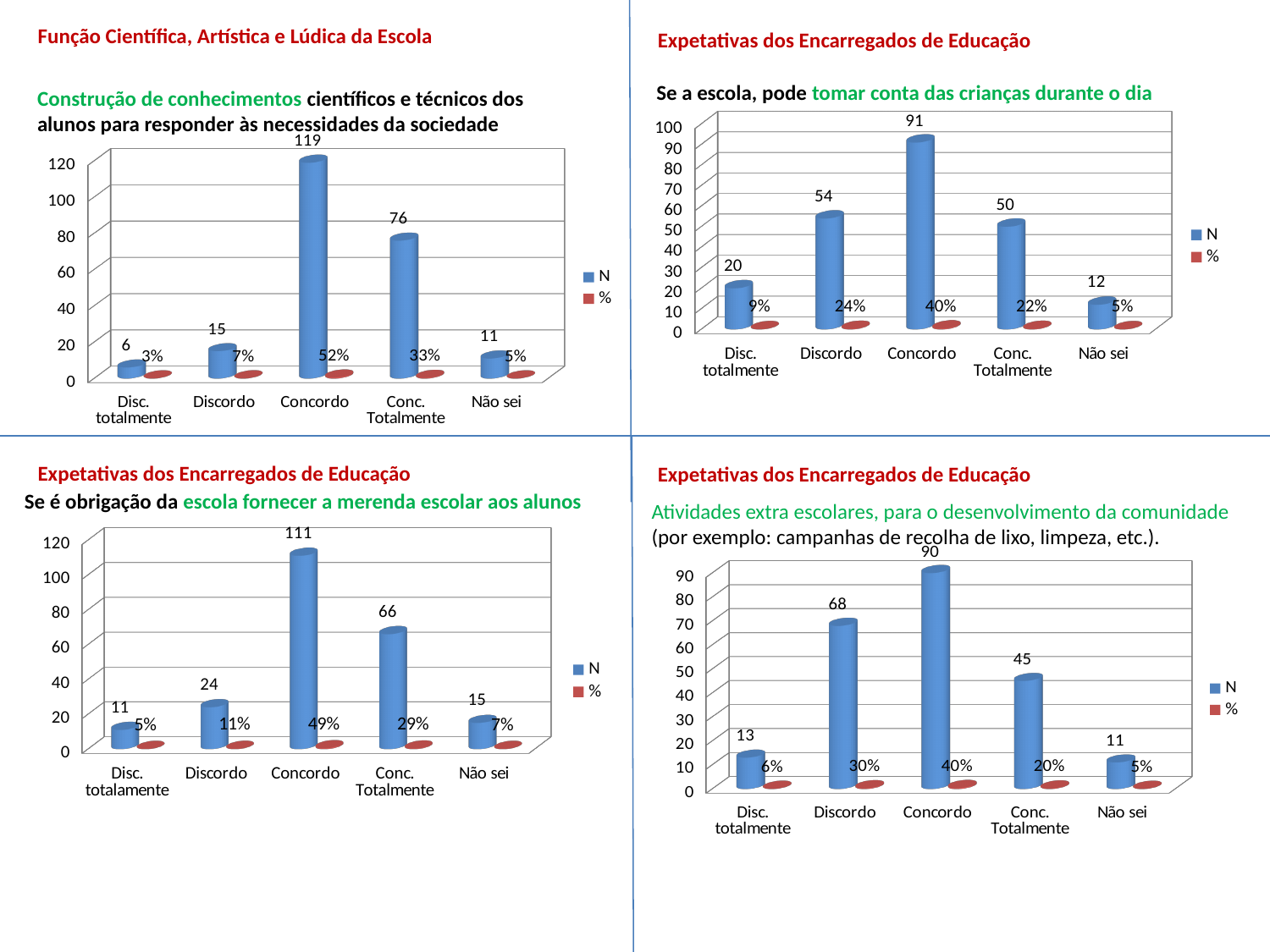
In the top-right chart, what is the N value for Discordo? 54 In the top-right chart, what is the difference between the N values for Concordo and Conc. Totalmente? 41 How many categories are shown on the x axis of the bottom-right chart? 5 How many series does the legend of the top-left chart list? 2 In the bottom-right chart, what is the N value for Discordo? 68 In the top-left chart, what is the N value for Concordo? 119 In the bottom-left chart, what percentage is shown for Concordo? 49% What type of chart is the bottom-left chart? Bar chart In the top-left chart, what percentage is shown for Conc. Totalmente? 33% In the bottom-left chart, which category has the lowest N value? Disc. totalmente In the top-right chart, which category has the highest N value? Concordo In the bottom-right chart, which is larger, the N value for Discordo or for Conc. Totalmente? Discordo